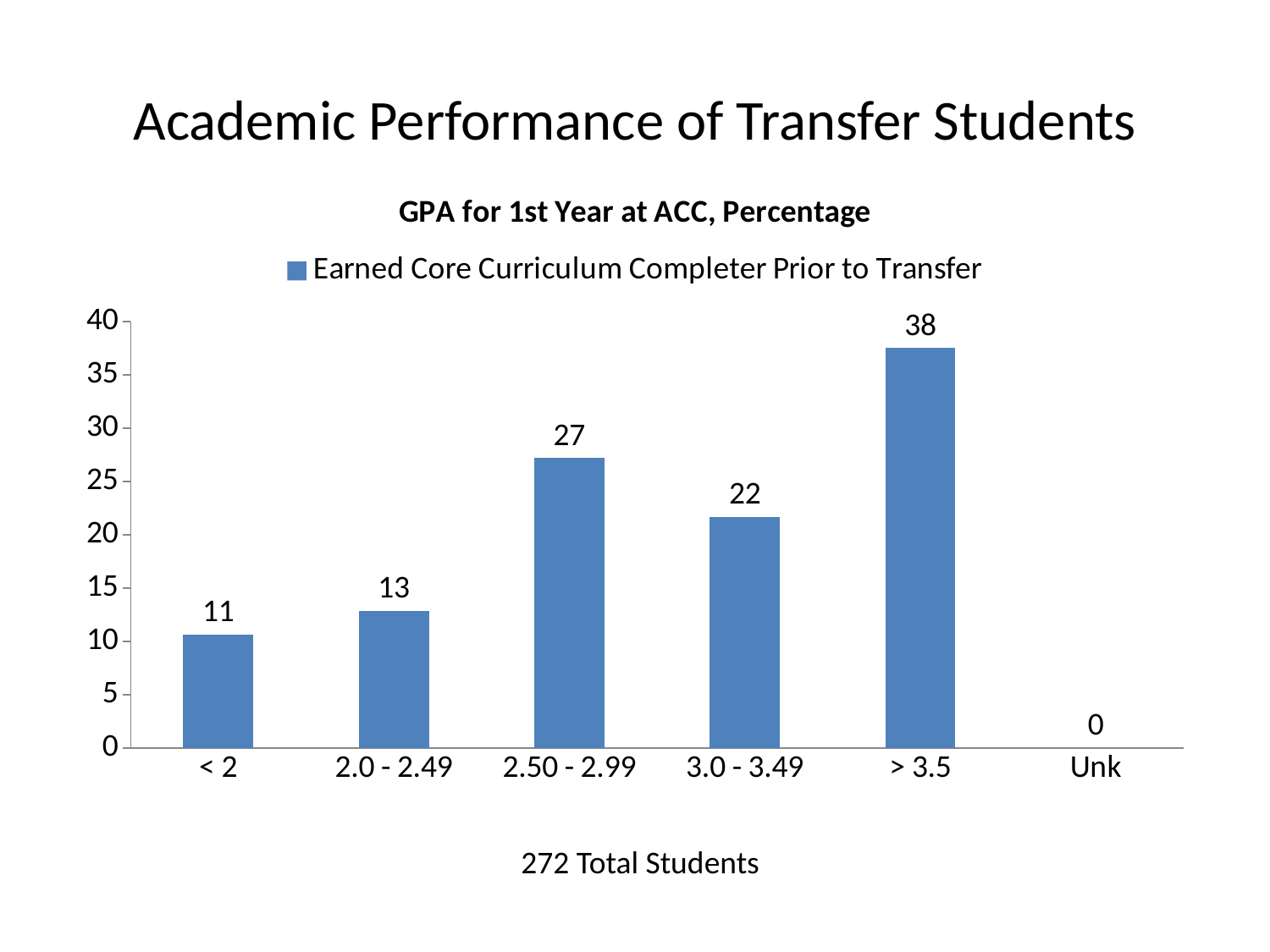
What is the value for the 2.50 - 2.99 GPA category? 27 What is the value for the > 3.5 GPA category? 38 What is the difference between the values for > 3.5 and 3.0 - 3.49? 16 Which GPA category has the highest value? > 3.5 Which GPA category has the lowest value? Unk How many series does the legend list? 1 Which is larger, the value for 2.0 - 2.49 or the value for 3.0 - 3.49? 3.0 - 3.49 What kind of chart is shown on the slide? Bar chart What is the value for the < 2 GPA category? 11 How many GPA categories are shown on the x axis? 6 What is the value for the Unk category? 0 What is the title of the chart? GPA for 1st Year at ACC, Percentage